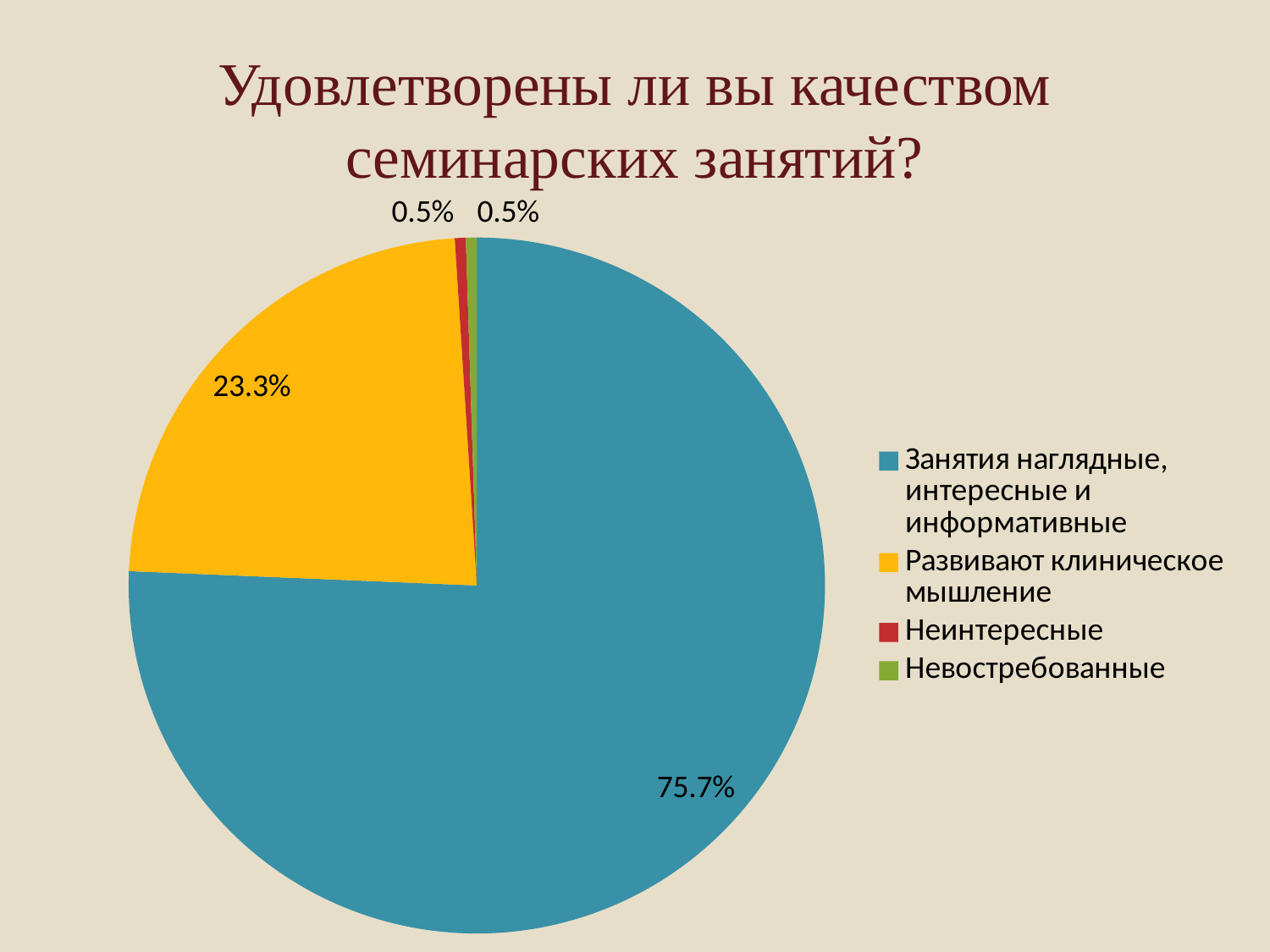
What share of the pie is labelled 'Развивают клиническое мышление'? 23.3% What kind of chart is shown on the slide? pie chart What share of the pie is labelled 'Занятия наглядные, интересные и информативные'? 75.7% What is the difference between the 'Занятия наглядные, интересные и информативные' slice and the 'Развивают клиническое мышление' slice? 52.4% What colour is the slice for 'Развивают клиническое мышление'? yellow What is the difference between the 'Развивают клиническое мышление' slice and the 'Неинтересные' slice? 22.8% Which is larger: the 'Развивают клиническое мышление' slice or the 'Невостребованные' slice? Развивают клиническое мышление What share of the pie is labelled 'Неинтересные'? 0.5% What is the title of the slide above the chart? Удовлетворены ли вы качеством семинарских занятий? Which category has the largest slice of the pie? Занятия наглядные, интересные и информативные How many categories does the legend list? 4 What share of the pie is labelled 'Невостребованные'? 0.5%